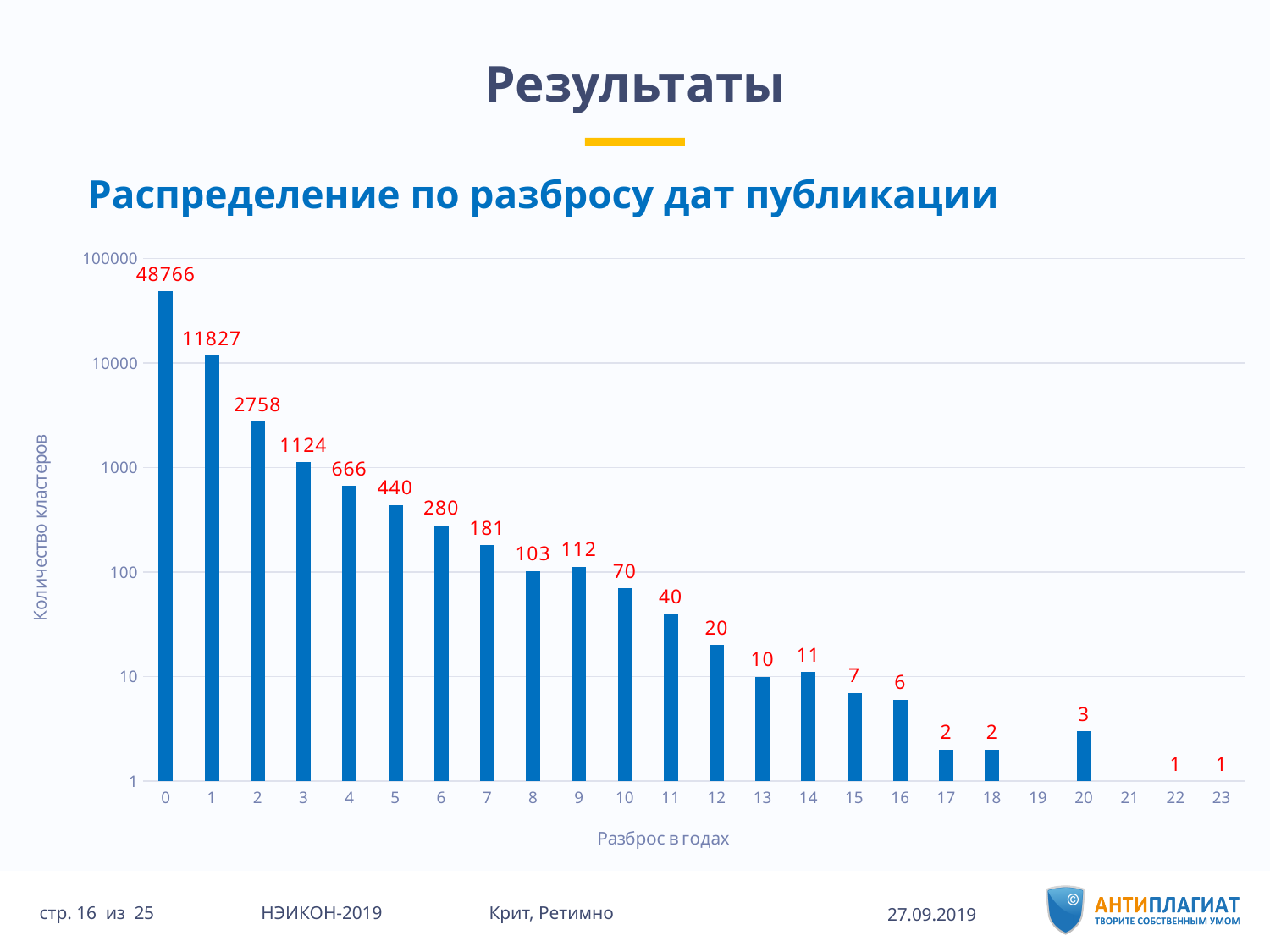
What is the difference between the values for 0 years and 1 year? 36939 Which spread in years has the highest number of clusters? 0 What is the value for a spread of 0 years? 48766 What kind of chart is shown on the slide? Bar chart How many categories are shown on the x axis? 24 What is the difference between the values for 9 years and 8 years? 9 What is the value for a spread of 20 years? 3 Which is larger, the value for 13 years or for 14 years? 14 years What is the title of the y axis? Количество кластеров Do the values generally rise or fall as the spread in years increases? Fall What is the value for a spread of 3 years? 1124 What is the value for a spread of 7 years? 181